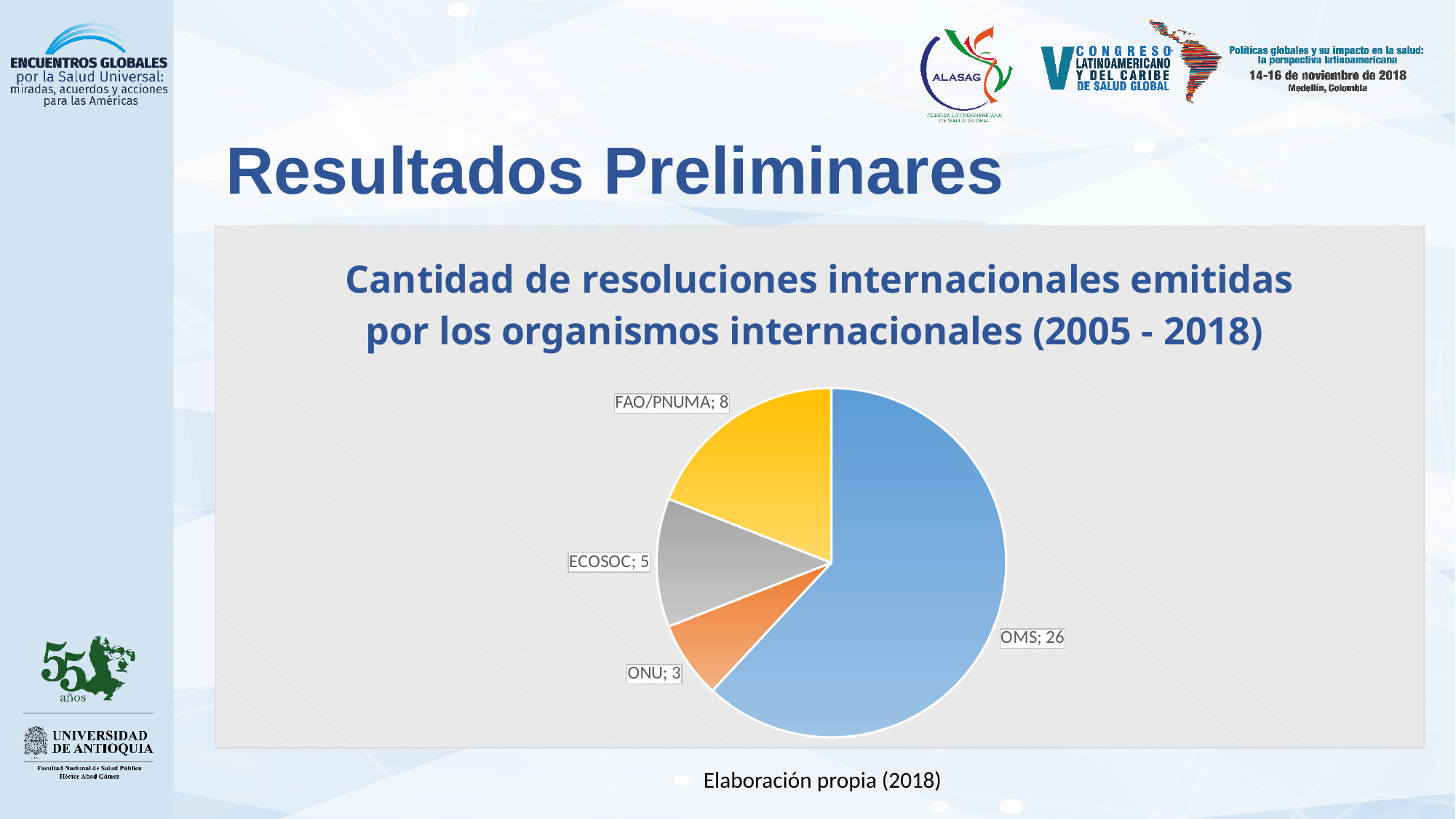
What is the value shown for ONU? 3 How many resolutions are attributed to OMS in the chart? 26 Which organism has the smallest slice of the pie? ONU What is the value shown for ECOSOC? 5 What is the value shown for FAO/PNUMA? 8 What is the title of the chart? Cantidad de resoluciones internacionales emitidas por los organismos internacionales (2005 - 2018) Which organism has the largest slice of the pie? OMS What kind of chart is shown on the slide? pie chart What is the total number of resolutions across all four organisms in the chart? 42 Which is larger, the value for ECOSOC or the value for ONU? ECOSOC How many slices (categories) does the pie chart have? 4 What is the difference between the values for OMS and FAO/PNUMA? 18